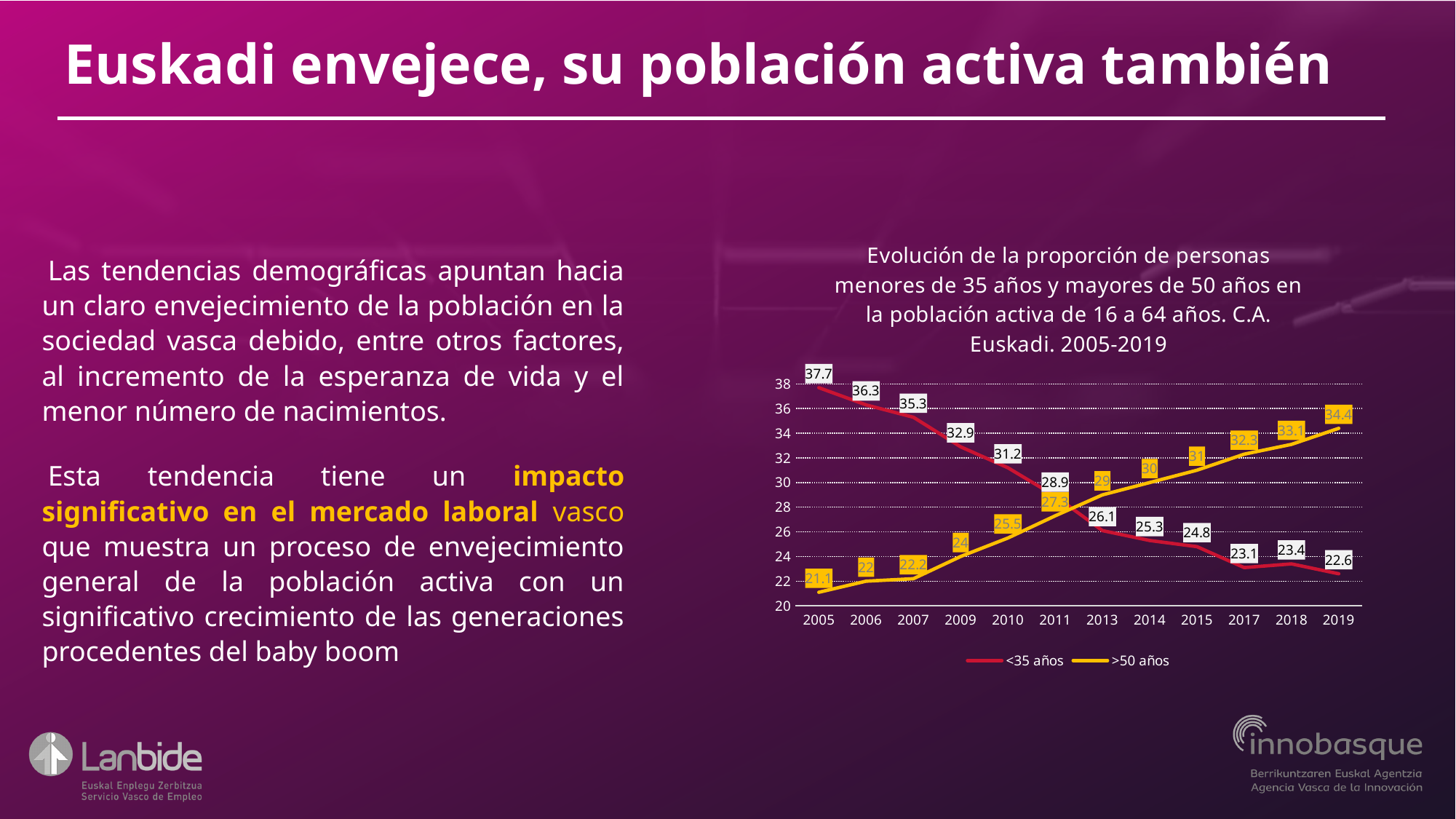
Does the >50 años series rise or fall from 2005 to 2019? rise What type of chart is shown on the slide? line chart In which year is the >50 años series at its highest? 2019 Which colour is used for the <35 años series? red What is the value for >50 años in 2011? 27.3 In 2013, which series has the larger value, <35 años or >50 años? >50 años In which year is the <35 años series at its lowest? 2019 How many series does the legend list? 2 What is the value for <35 años in 2005? 37.7 What is the difference between the <35 años value in 2005 and in 2019? 15.1 How many years are shown on the x axis of the chart? 12 What is the value for >50 años in 2019? 34.4